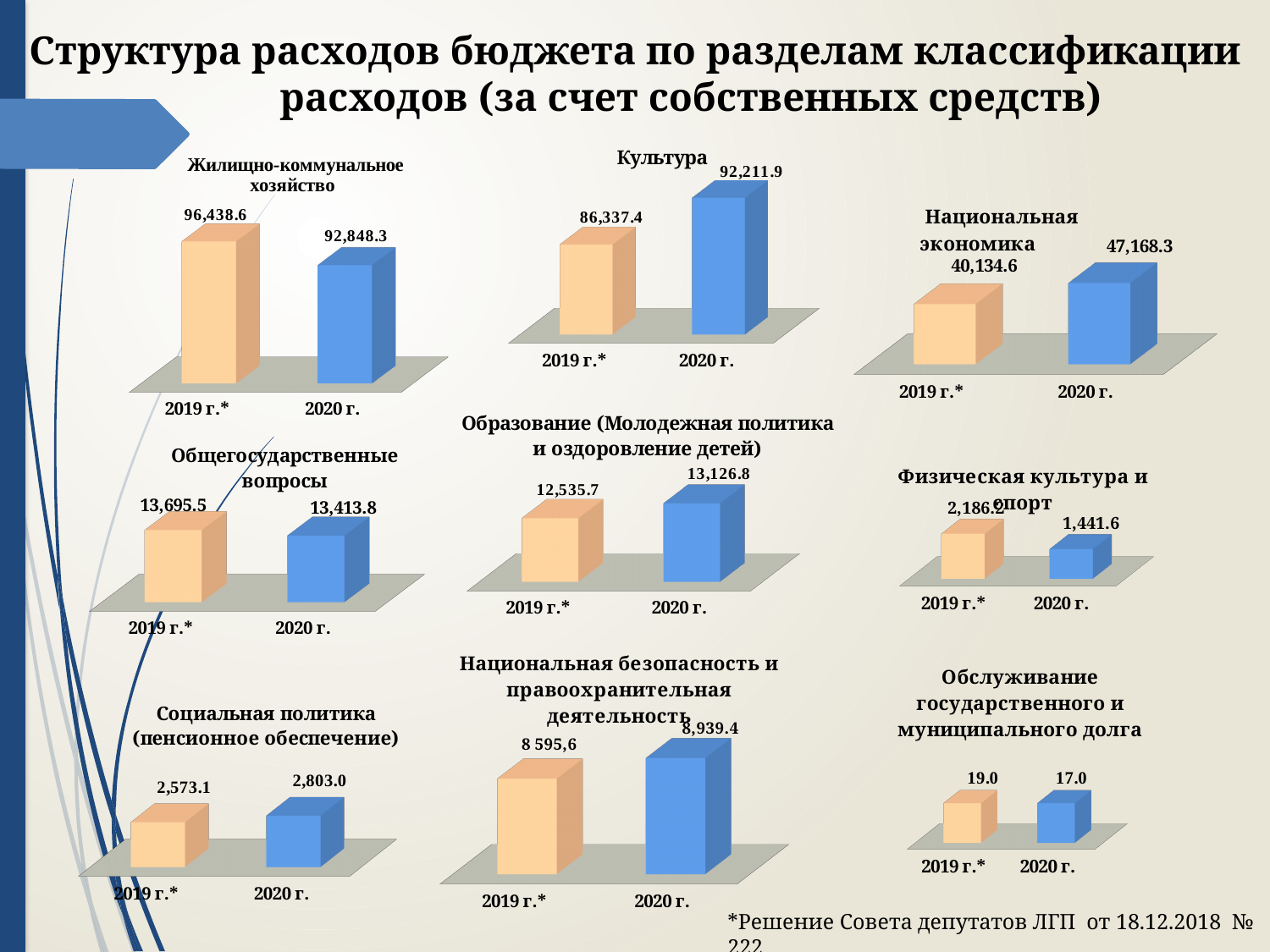
In the 'Обслуживание государственного и муниципального долга' chart, which year has the higher value? 2019 г.* In the 'Жилищно-коммунальное хозяйство' chart, what is the value for 2019 г.*? 96,438.6 In the 'Социальная политика (пенсионное обеспечение)' chart, is the value for 2020 г. larger or smaller than the value for 2019 г.*? larger In the 'Национальная экономика' chart, what is the value for 2019 г.*? 40,134.6 In the 'Общегосударственные вопросы' chart, which year has the lower value? 2020 г. In the 'Образование (Молодежная политика и оздоровление детей)' chart, do the values rise or fall from 2019 г.* to 2020 г.? rise In the 'Культура' chart, what is the difference between the 2020 г. and 2019 г.* values? 5,874.5 In the 'Физическая культура и спорт' chart, what is the value for 2020 г.? 1,441.6 How many bars does the 'Национальная безопасность и правоохранительная деятельность' chart have? 2 In the 'Национальная экономика' chart, what is the difference between the 2020 г. and 2019 г.* values? 7,033.7 What kind of chart is used for 'Жилищно-коммунальное хозяйство'? bar chart In the 'Культура' chart, what is the value for 2020 г.? 92,211.9